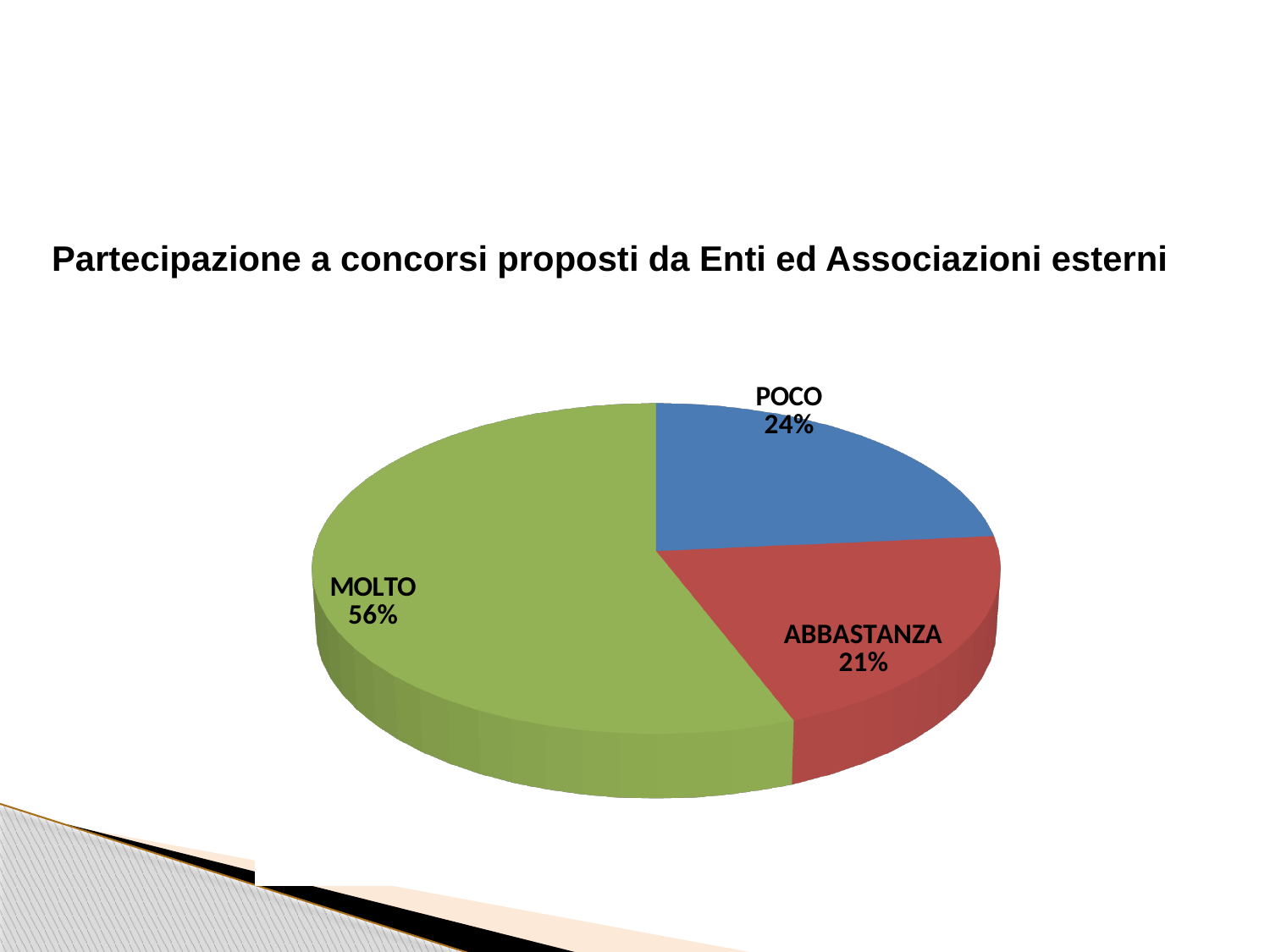
What percentage is shown for ABBASTANZA? 21% What is the title of the chart? Partecipazione a concorsi proposti da Enti ed Associazioni esterni How many slices does the pie chart have? 3 What kind of chart is shown on the slide? pie chart Which is larger, the share for MOLTO or the share for ABBASTANZA? MOLTO What colour is the MOLTO slice? green Which category has the largest share of the pie? MOLTO Which category has the smallest share of the pie? ABBASTANZA What percentage is shown for MOLTO? 56% What is the difference in percentage points between POCO and ABBASTANZA? 3 What is the difference in percentage points between MOLTO and POCO? 32 What percentage is shown for POCO? 24%